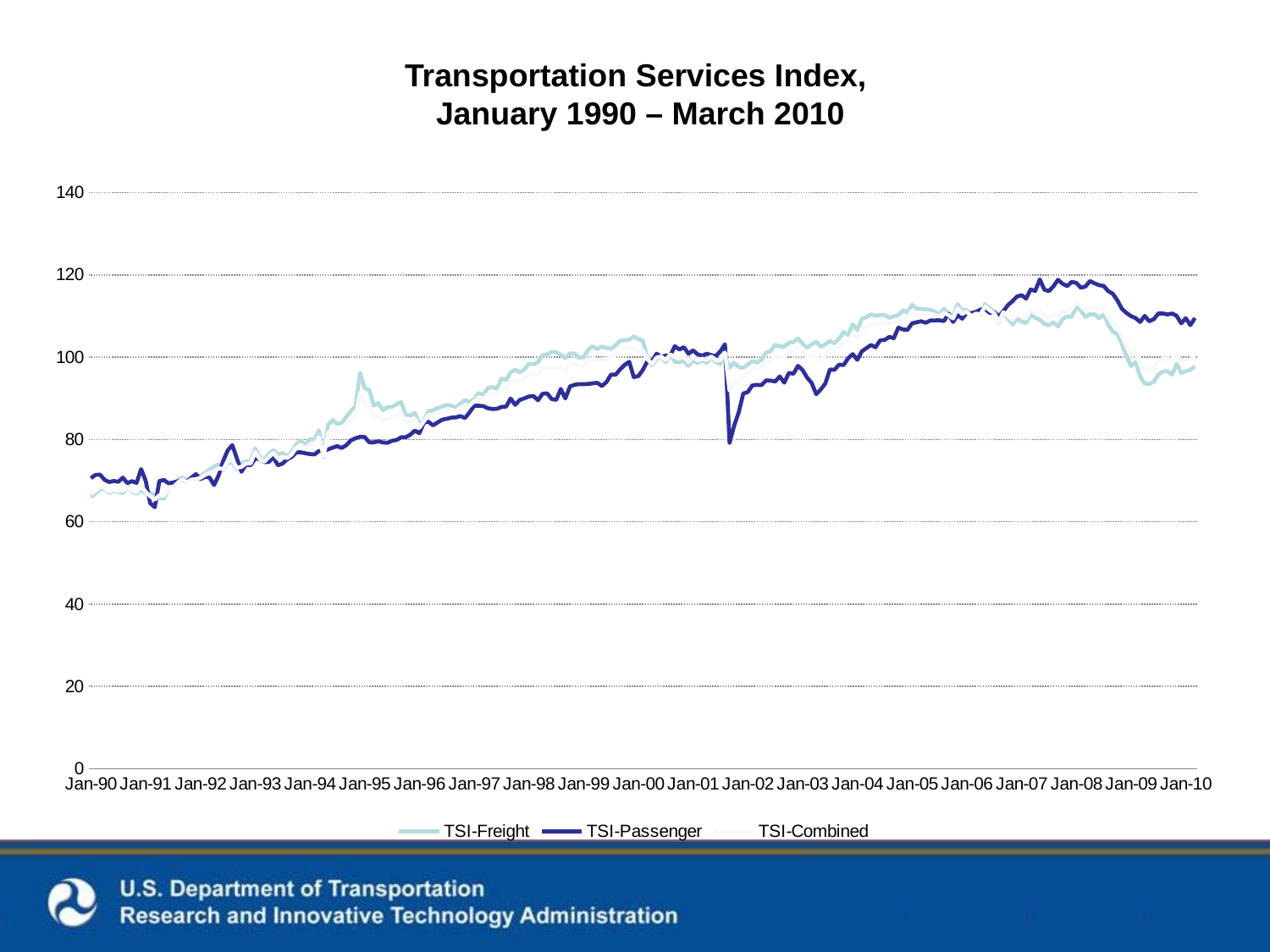
At Jan-08, which is higher, TSI-Passenger or TSI-Freight? TSI-Passenger What kind of chart is shown on the slide? line chart In which year does TSI-Passenger show a sudden sharp drop? 2001 Is the value of TSI-Passenger at Jan-08 greater or less than 100? greater Is the value of TSI-Passenger at Jan-90 greater or less than 80? less Is the value of TSI-Freight at Jan-90 greater or less than 60? greater What is the title of the chart? Transportation Services Index, January 1990 – March 2010 Which series is drawn with the dark blue line? TSI-Passenger How many series does the legend list? 3 Does TSI-Passenger generally rise or fall from Jan-90 to Jan-10? rise